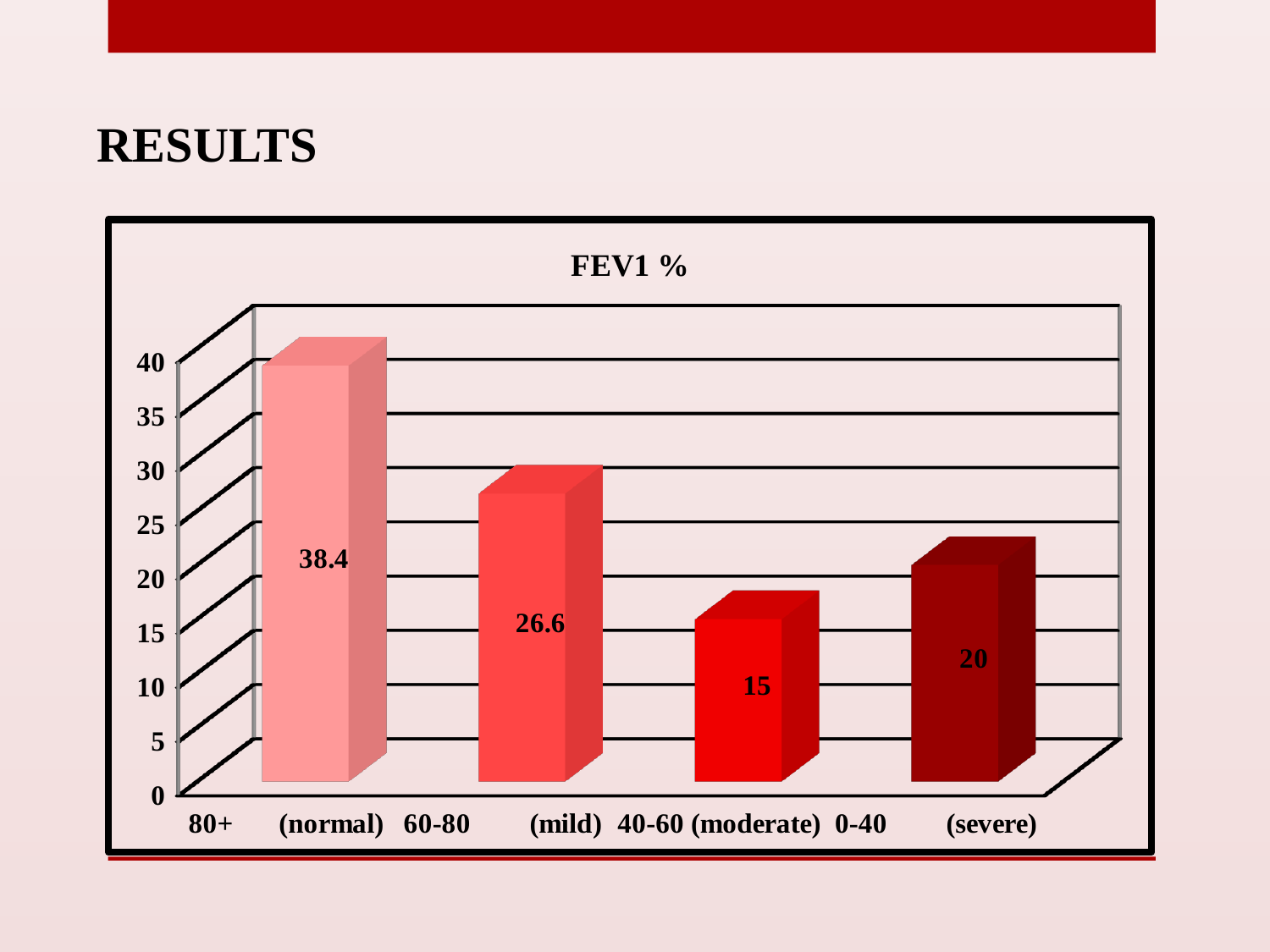
Which category has the lowest value? 40-60 (moderate) What is the title of the chart? FEV1 % What is the difference between the values for 80+ (normal) and 60-80 (mild)? 11.8 How many categories are shown in the chart? 4 Which is larger, the value for 60-80 (mild) or the value for 0-40 (severe)? 60-80 (mild) What is the value for the 60-80 (mild) category? 26.6 What is the value for the 80+ (normal) category in the FEV1 % chart? 38.4 What kind of chart is shown on the slide? Bar chart What is the difference between the values for 0-40 (severe) and 40-60 (moderate)? 5 What is the value for the 0-40 (severe) category? 20 What is the value for the 40-60 (moderate) category? 15 Which category has the highest value? 80+ (normal)